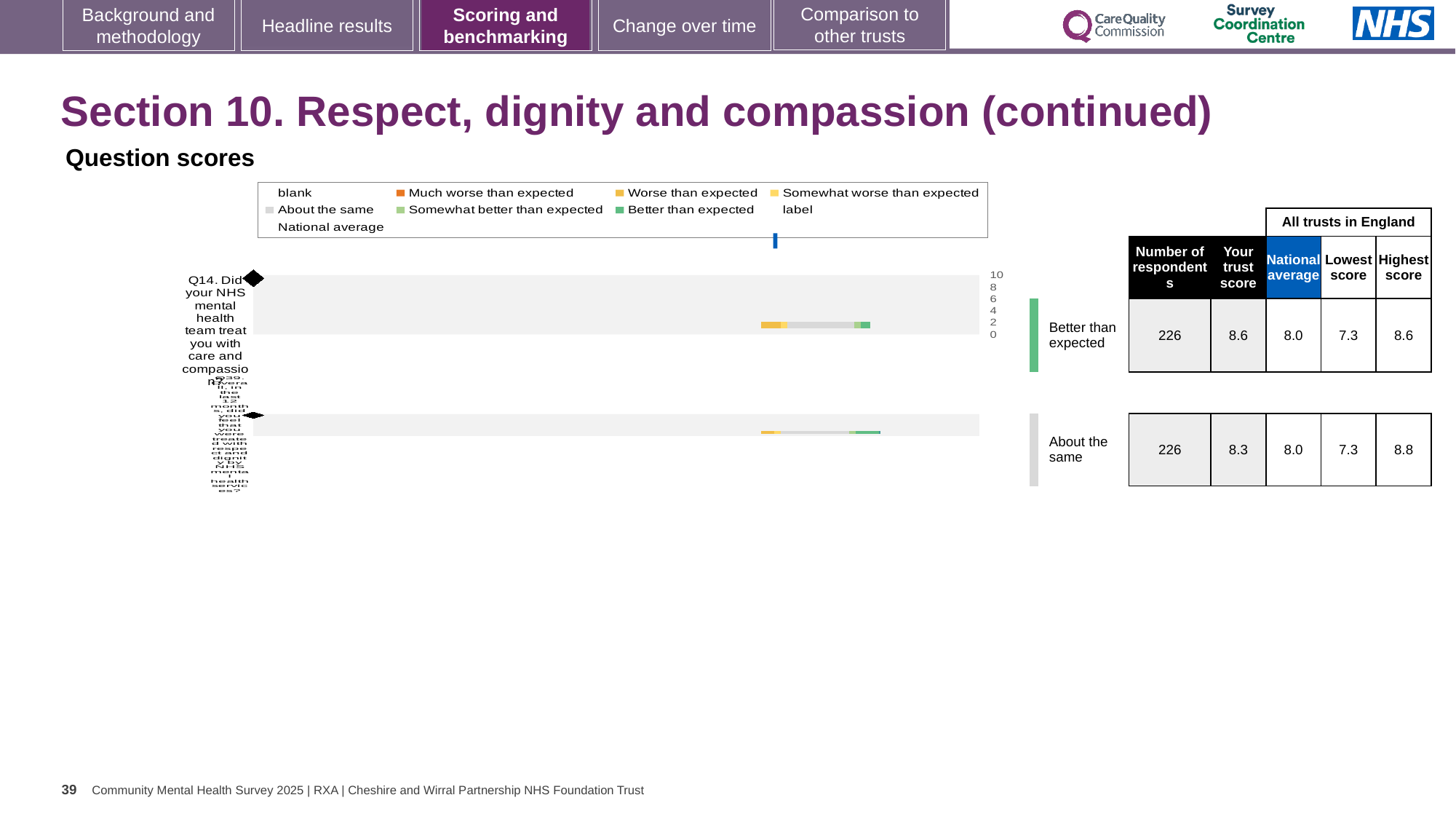
Which benchmark category is shown for Q14 in the question scores chart? Better than expected How much higher is the trust score for Q14 than the national average for Q14? 0.6 What is the trust score for Q14 (Did your NHS mental health team treat you with care and compassion?)? 8.6 Which question has the higher trust score, Q14 or Q39? Q14 How many respondents answered Q39? 226 How many survey questions are plotted in the question scores chart? 2 What is the trust score for Q39 (Overall in the last 12 months, did you feel that you were treated with respect and dignity by NHS mental health services?)? 8.3 What is the national average score shown for Q14? 8.0 What is the highest score among all trusts in England for Q39? 8.8 What kind of chart is used to show the question scores on this slide? bar chart What is the lowest score among all trusts in England for Q14? 7.3 What is the difference between the trust score for Q14 and the trust score for Q39? 0.3